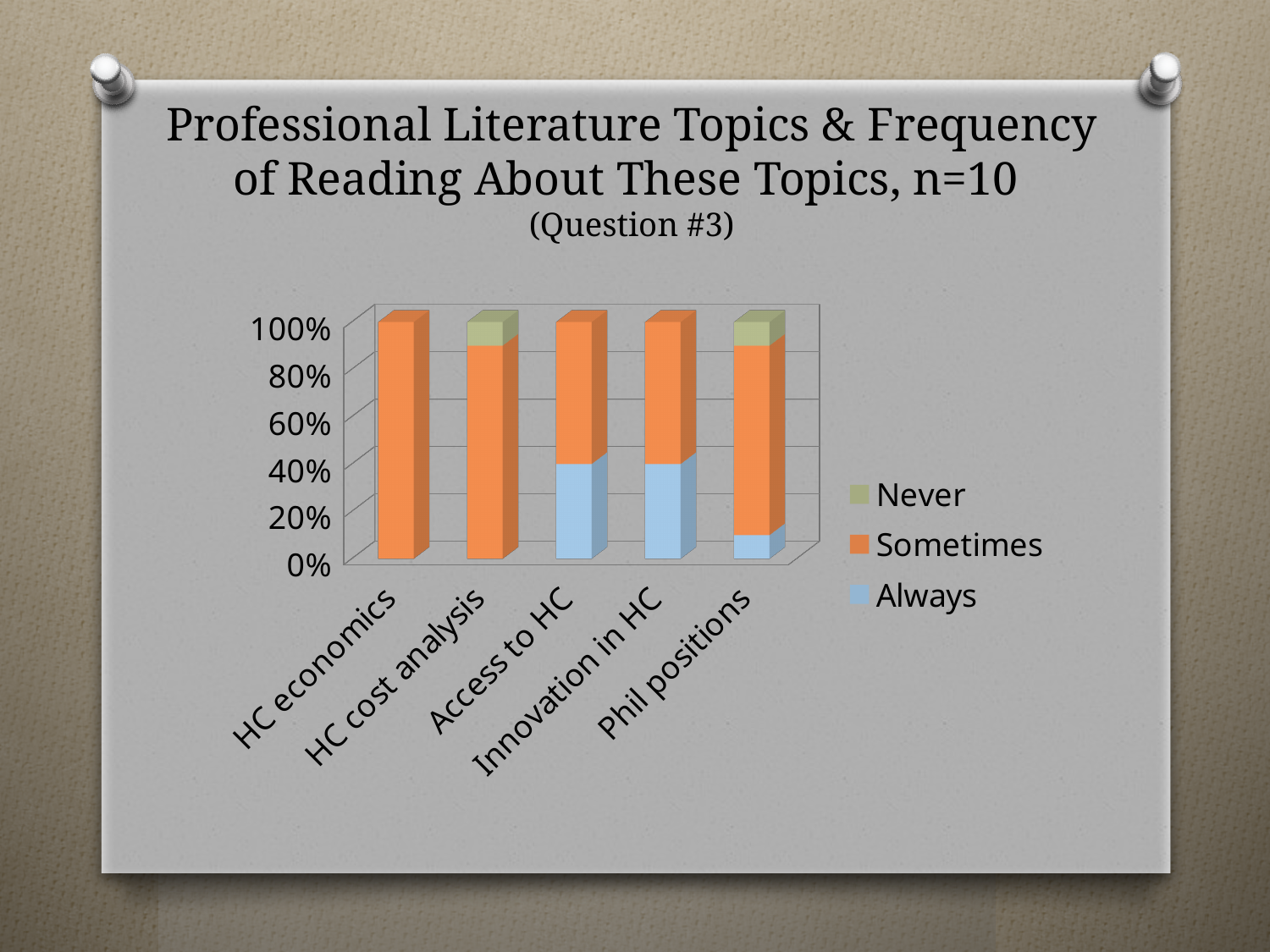
Which categories include a 'Never' segment? HC cost analysis and Phil positions Is the 'Always' share for Access to HC greater or less than 20%? greater What is the total of the stacked bar for Innovation in HC? 100% Which category has the largest 'Sometimes' share? HC economics Which is larger, the 'Always' share for Access to HC or for Phil positions? Access to HC What is the 'Sometimes' share for HC economics? 100% What are the three series listed in the legend? Never, Sometimes, Always How many series does the legend list? 3 What kind of chart is shown on the slide? Stacked bar chart Is the 'Never' share for HC cost analysis greater or less than 20%? less How many topic categories are shown on the x axis? 5 Is the 'Always' share for Phil positions greater or less than 20%? less